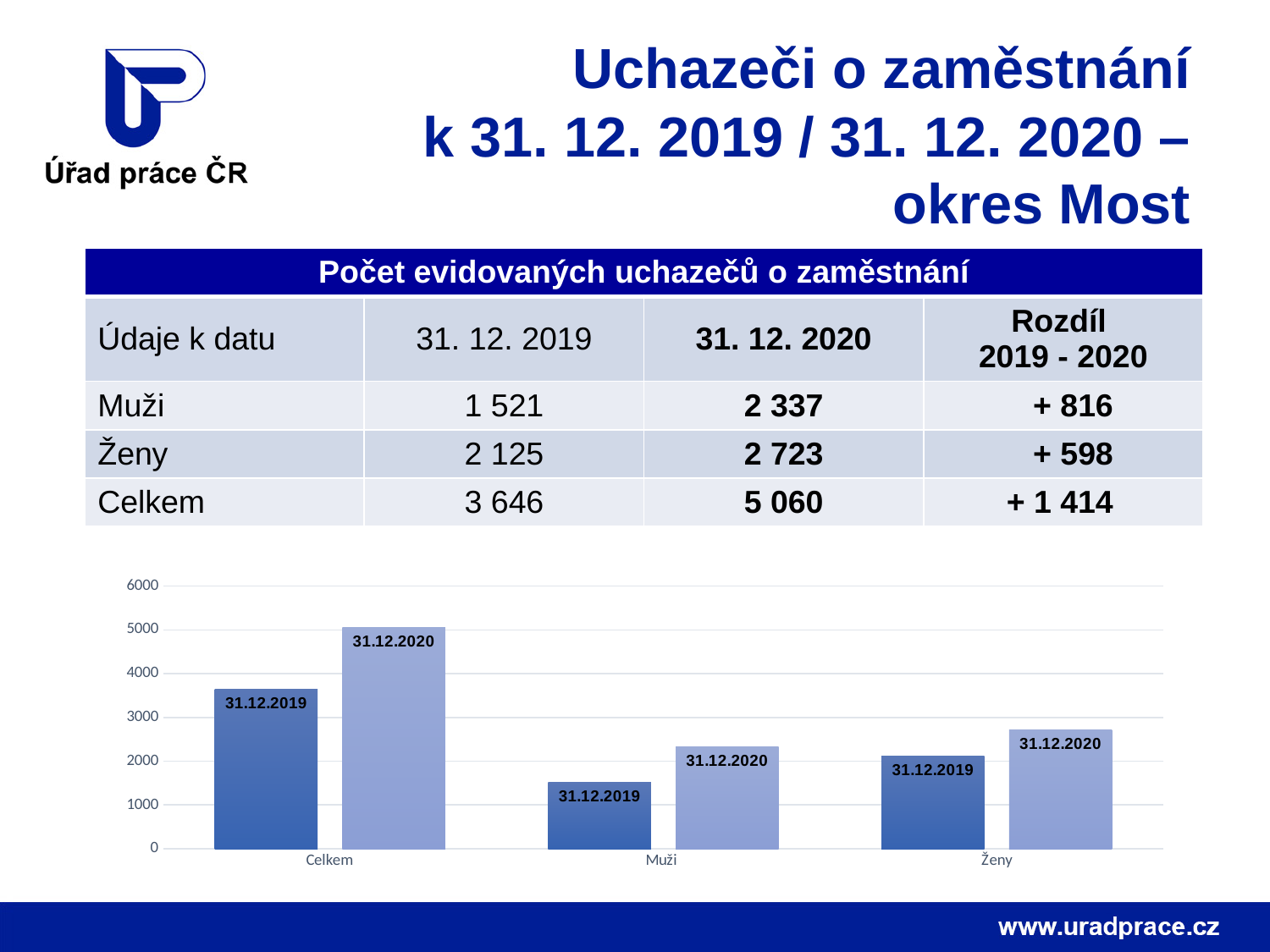
What kind of chart is shown on the slide? bar chart How many categories are shown on the x axis of the chart? 3 Is the 31.12.2020 bar for Celkem greater or less than 4000? greater Which bar in the chart is the shortest? Muži, 31.12.2019 In each category, is the 31.12.2020 bar higher or lower than the 31.12.2019 bar? higher According to the slide, what is the difference between the Celkem bars for 31.12.2020 and 31.12.2019? + 1 414 Is the 31.12.2020 bar for Ženy greater or less than 3000? less Is the 31.12.2019 bar for Celkem greater or less than 3000? greater Which bar in the chart is the tallest? Celkem, 31.12.2020 According to the slide, what is the value of the Celkem bar for 31.12.2020? 5 060 For 31.12.2020, which bar is taller: Muži or Ženy? Ženy